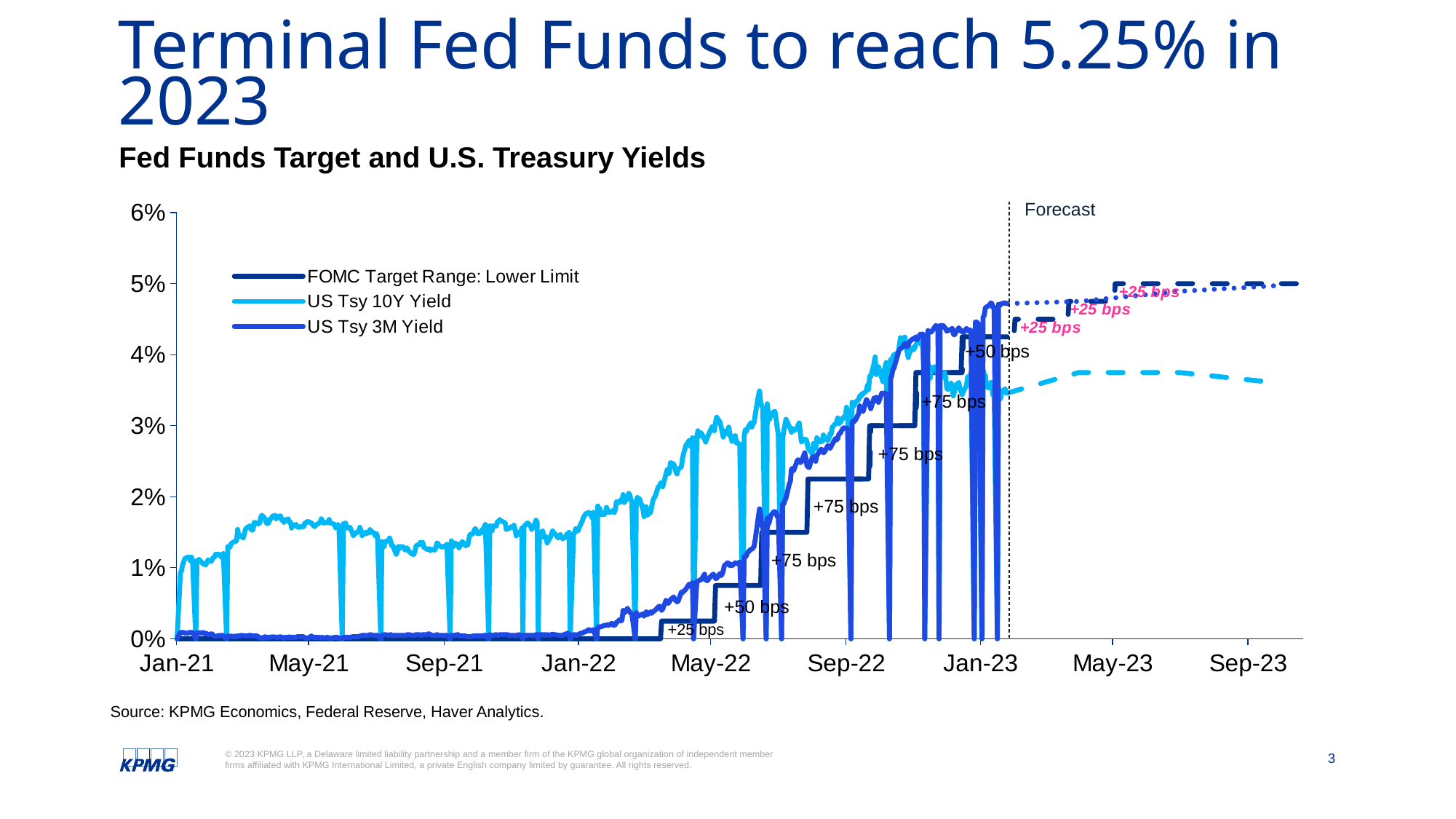
Is the value of the FOMC Target Range: Lower Limit in Jan-21 greater or less than 1%? less Is the US Tsy 10Y Yield in May-21 greater or less than 2%? less Is the forecast value of the FOMC Target Range: Lower Limit at Sep-23 greater or less than 4%? greater How many rate hikes on the chart are annotated as +75 bps? 4 Which series is labelled in the legend with the darkest blue line? FOMC Target Range: Lower Limit Does the FOMC Target Range: Lower Limit rise or fall from Jan-22 to Jan-23? Rise What is the size of the first rate hike annotated on the chart, in early 2022? +25 bps How many series does the chart legend list? 3 What kind of chart is shown on the slide? Line chart What is the size of each of the three rate hikes annotated in the forecast period? +25 bps What is the title of the chart? Fed Funds Target and U.S. Treasury Yields